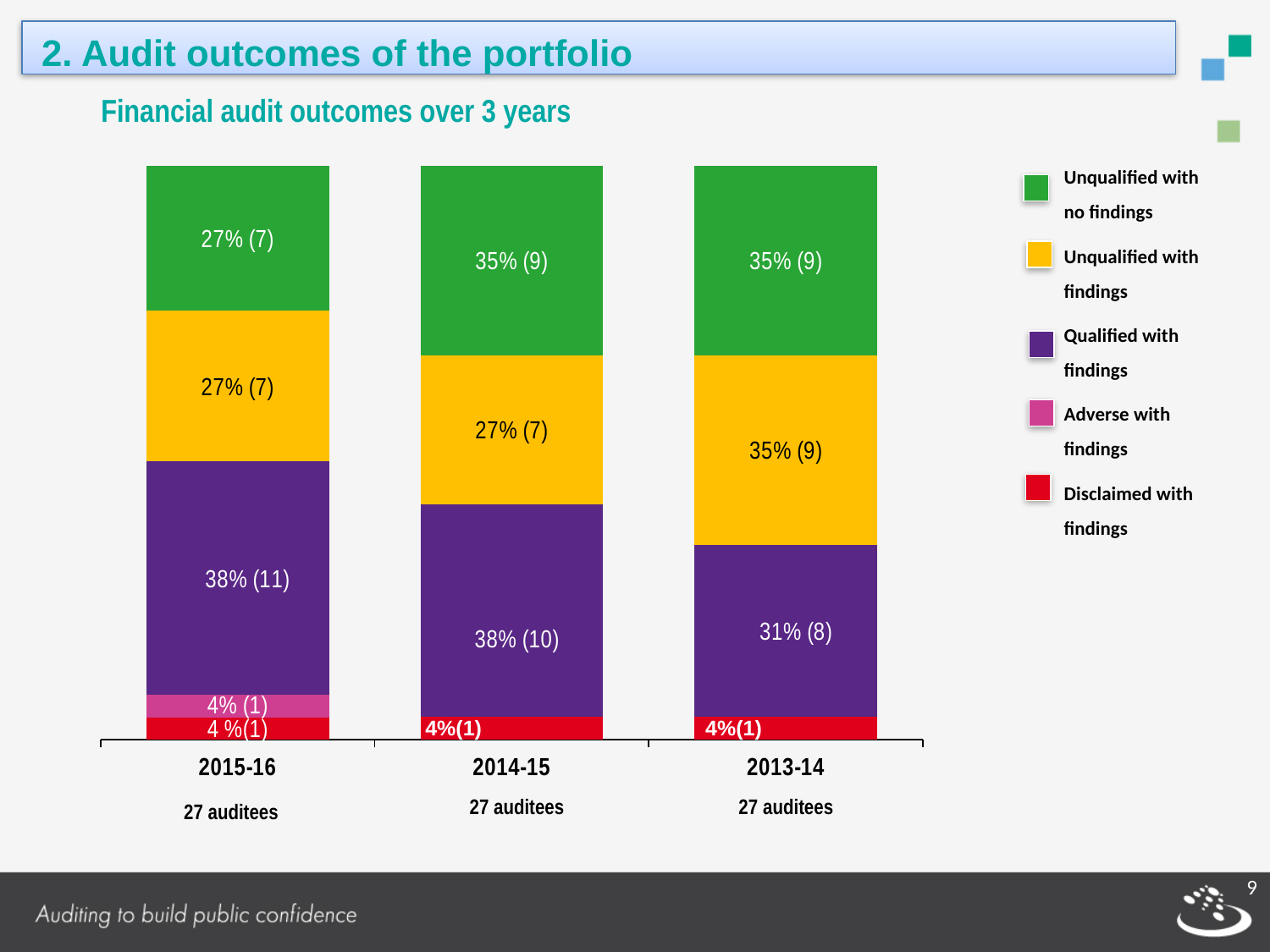
How many years (bars) are shown on the x axis of the chart? 3 What is the value for 'Qualified with findings' in 2015-16? 38% (11) How many audit outcome categories does the legend list? 5 Which year has the larger percentage for 'Qualified with findings', 2014-15 or 2013-14? 2014-15 What is the value for 'Unqualified with no findings' in 2014-15? 35% (9) Reading the bars from left to right (2015-16 to 2013-14), does the 'Unqualified with no findings' percentage rise or fall? Rise How many more auditees were 'Qualified with findings' in 2015-16 than in 2013-14? 3 In 2015-16, which audit outcome has the largest share of the bar? Qualified with findings What is the value for 'Unqualified with findings' in 2013-14? 35% (9) What is the value for 'Adverse with findings' in 2015-16? 4% (1) What is the title of the chart? Financial audit outcomes over 3 years What kind of chart is shown on the slide? Stacked bar chart